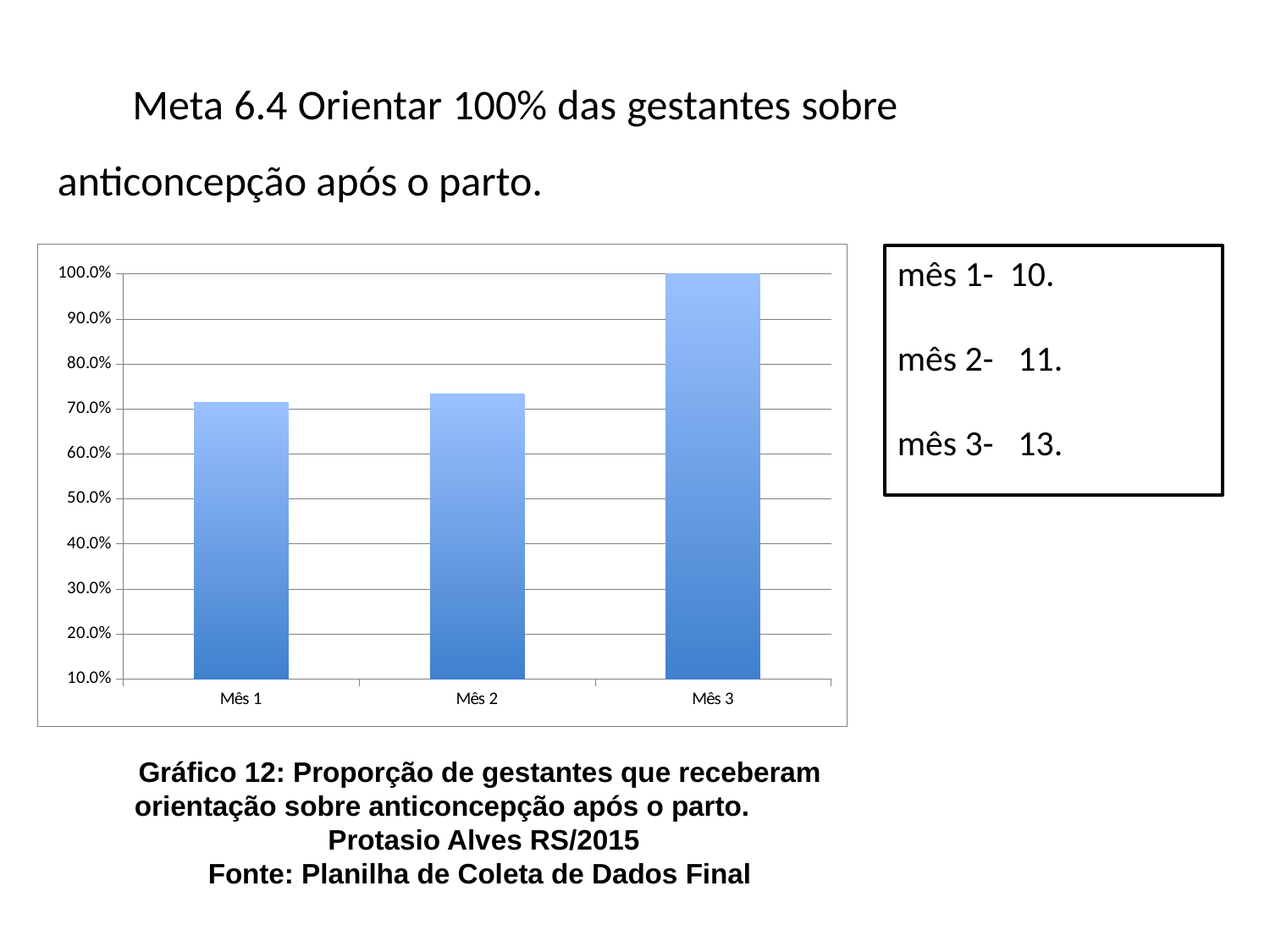
Is the value for Mês 3 larger than the value for Mês 1? Yes How many bars (categories) does the chart show? 3 Which month has the highest bar in the chart? Mês 3 What is the value for Mês 3 in the chart? 100.0% Is the value for Mês 1 greater or less than 80.0%? less Is the value for Mês 3 greater or less than 90.0%? greater Is the value for Mês 2 greater or less than 60.0%? greater What is the lowest value shown on the vertical axis of the chart? 10.0% Do the values rise or fall from Mês 1 to Mês 3? rise What kind of chart is shown on the slide? bar chart What is the caption number given for the chart (Gráfico)? Gráfico 12